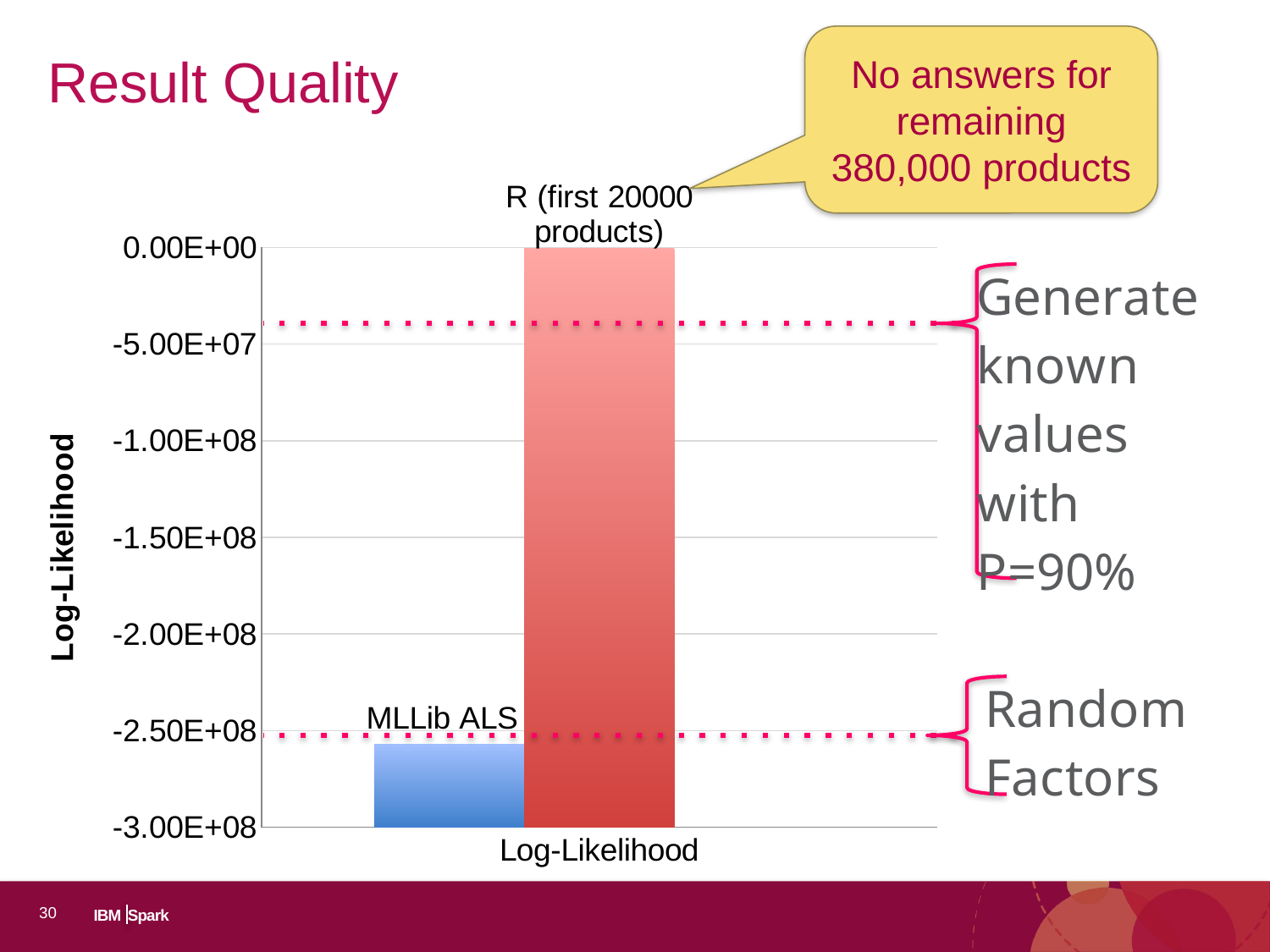
Which bar shows the highest log-likelihood? R (first 20000 products) What kind of chart is shown on the slide? bar chart Which bar shows the lowest log-likelihood? MLLib ALS What is the highest value shown on the vertical axis? 0.00E+00 What colour is the MLLib ALS bar? blue Is the value for MLLib ALS greater or less than -3.00E+08? greater Which bar has the higher log-likelihood value, MLLib ALS or R (first 20000 products)? R (first 20000 products) What is the title of the vertical axis of the chart? Log-Likelihood Is the value for R (first 20000 products) greater or less than -5.00E+07? greater How many bars are plotted in the chart? 2 What is the lowest value shown on the vertical axis? -3.00E+08 Is the value for MLLib ALS greater or less than -2.00E+08? less